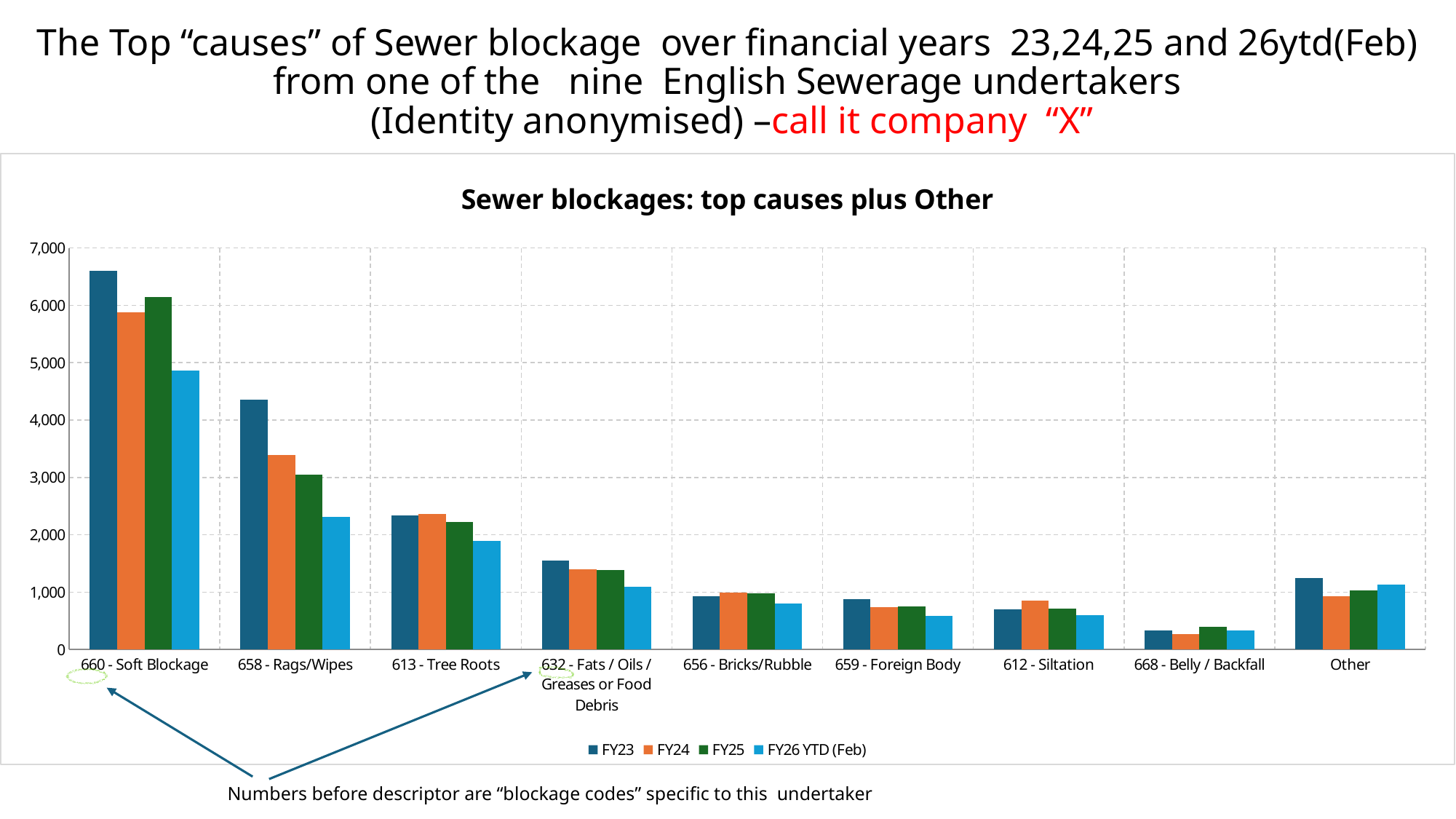
Do the values for 658 - Rags/Wipes rise or fall from FY23 through to FY26 YTD (Feb)? fall Which category has the lowest bars in the chart? 668 - Belly / Backfall What kind of chart is shown on the slide? bar chart What is the title of the chart? Sewer blockages: top causes plus Other For 660 - Soft Blockage, which is larger: the FY23 value or the FY24 value? FY23 Is the FY23 value for Other greater or less than 1,000? greater Is the FY26 YTD (Feb) value for 613 - Tree Roots greater or less than 2,000? less Is the FY23 value for 658 - Rags/Wipes greater or less than 4,000? greater Which category has the highest bar in the chart? 660 - Soft Blockage How many series does the legend list? 4 How many categories are shown on the x axis? 9